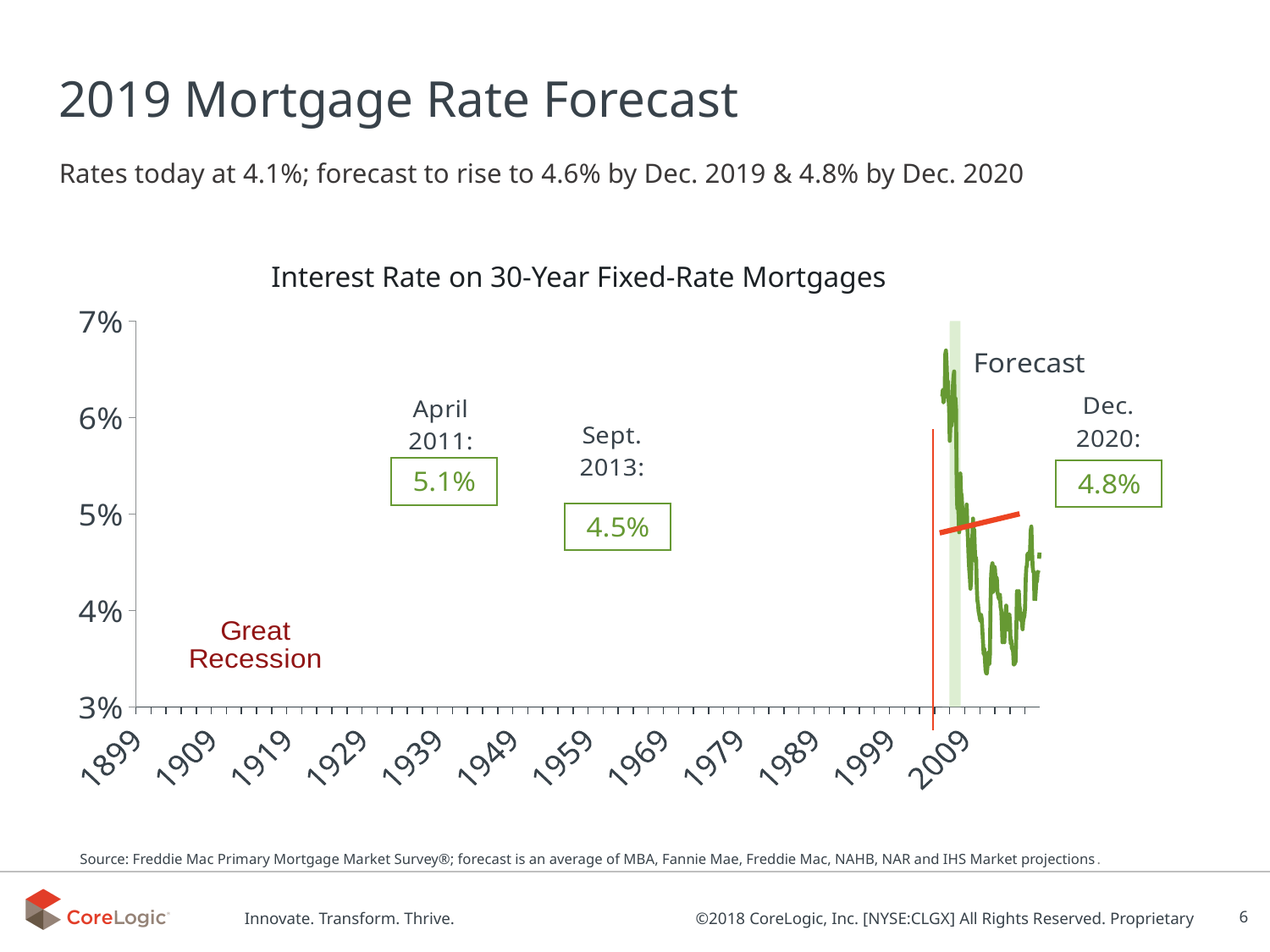
Which labeled value is larger: April 2011 or Dec. 2020? April 2011 What is the title of the chart? Interest Rate on 30-Year Fixed-Rate Mortgages Which labeled value is smaller: Sept. 2013 or Dec. 2020? Sept. 2013 Is the highest point of the plotted line greater or less than 6%? greater What is the difference between the labeled rate for April 2011 and the labeled rate for Sept. 2013? 0.6 percentage points What mortgage rate is labeled for April 2011 on the chart? 5.1% What mortgage rate is labeled for Sept. 2013 on the chart? 4.5% What forecast mortgage rate is labeled for Dec. 2020 on the chart? 4.8% Is the lowest point of the plotted line greater or less than 4%? less Does the plotted line generally rise or fall from its starting point to its lowest point? fall What type of chart is shown on the slide? line chart What is the highest value shown on the vertical axis? 7%